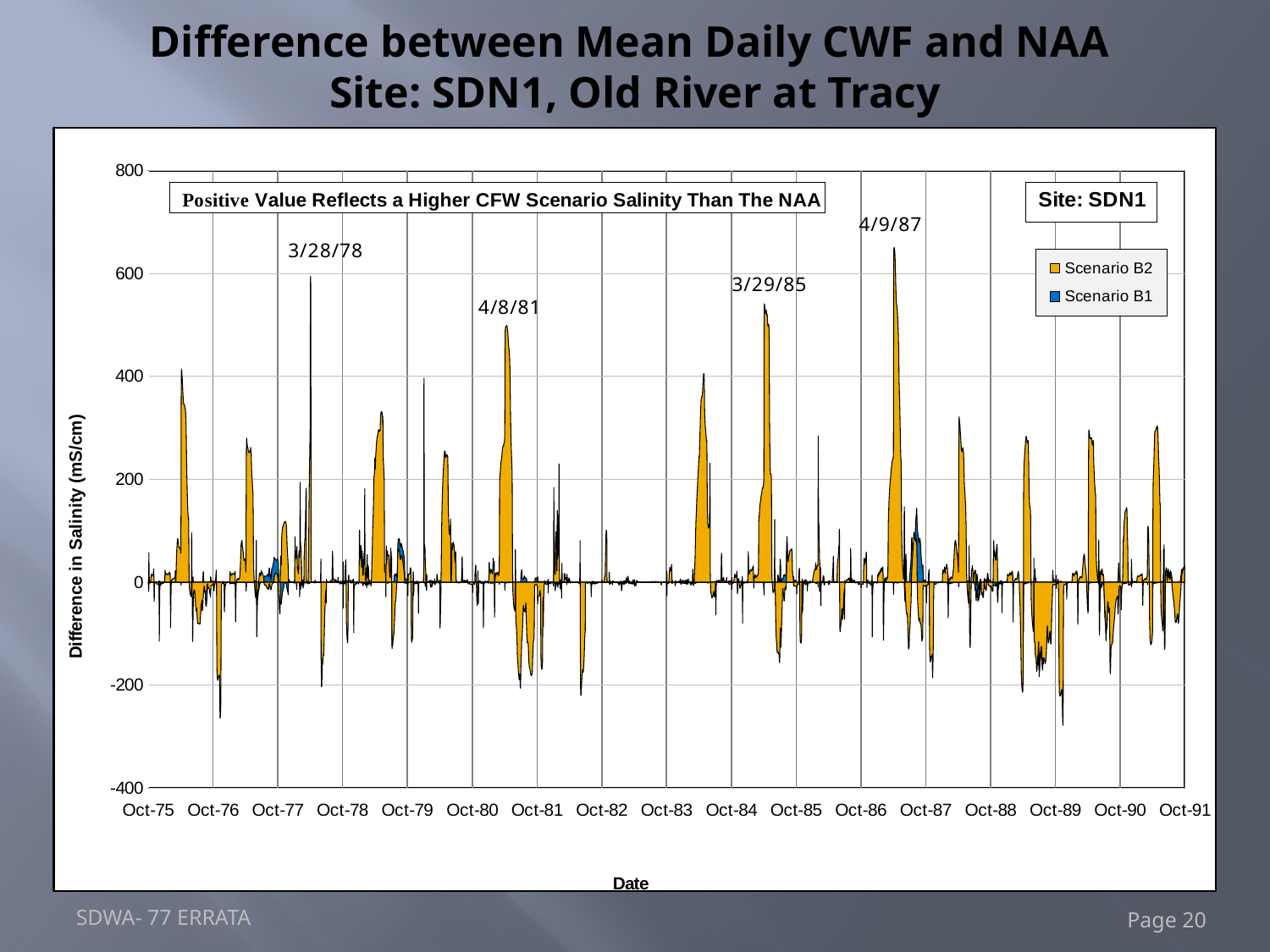
What is the label of the y axis? Difference in Salinity (mS/cm) Of the four annotated dates, which one marks the highest peak? 4/9/87 Which peak is higher, the one annotated 4/9/87 or the one annotated 4/8/81? 4/9/87 Is the peak value annotated 3/29/85 greater or less than 400? greater What are the two series named in the legend? Scenario B2 and Scenario B1 Which peak is higher, the one annotated 3/29/85 or the one annotated 4/8/81? 3/29/85 How many date labels are shown along the x axis? 17 What kind of chart is shown on the slide? area chart Is the peak value annotated 4/8/81 greater or less than 400? greater How many series does the legend list? 2 Is the lowest value plotted near Oct-89 greater or less than -200? less